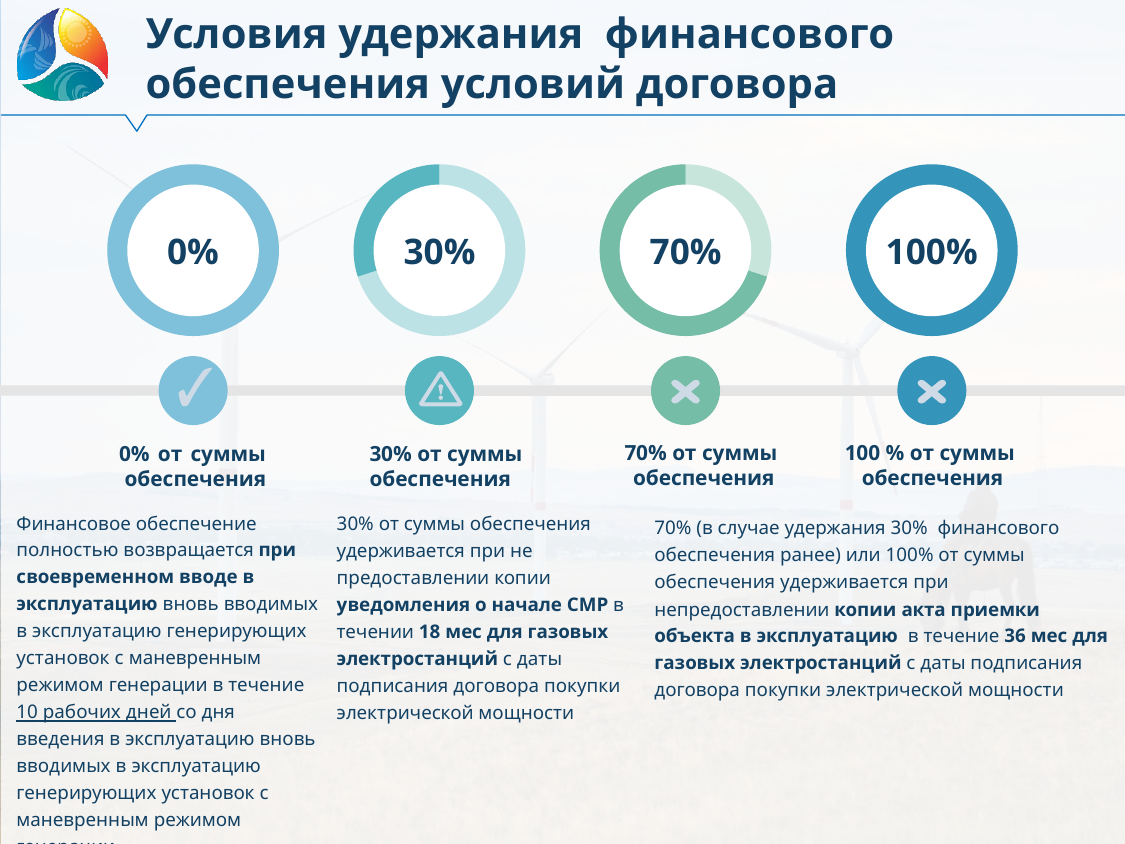
What value is shown in the third ring chart from the left? 70% How many ring charts are shown on the slide? 4 Do the values in the ring charts rise or fall from left to right? Rise What value is shown in the second ring chart from the left? 30% What value is shown in the leftmost ring chart? 0% Which ring chart shows the highest value? The rightmost one, 100% What value is shown in the rightmost ring chart? 100% What is the difference between the value in the third ring chart and the value in the second ring chart? 40% Which is larger: the value in the second ring chart or the value in the third ring chart? The third ring chart (70%) Which ring chart shows the lowest value? The leftmost one, 0% What icon is shown below the 0% ring chart? A check mark What kind of charts are the four circular graphics on the slide? Donut (ring) charts